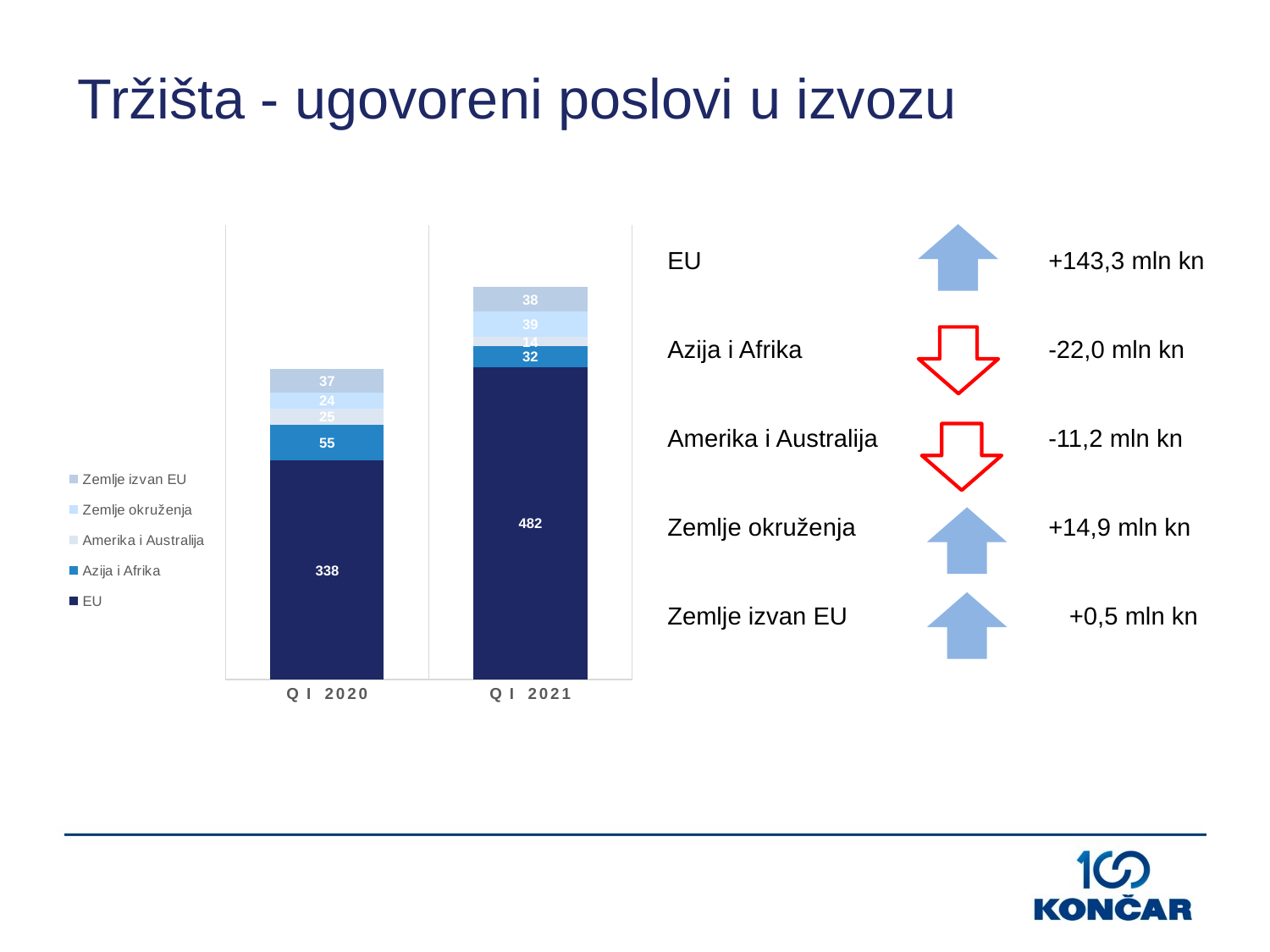
What is the value for EU in Q I 2021? 482 How many categories are shown on the x axis? 2 What is the total of the stacked bar for Q I 2021? 605 What kind of chart is shown on the slide? Stacked bar chart What is the value for Zemlje izvan EU in Q I 2020? 37 Which is larger, the Azija i Afrika value in Q I 2020 or in Q I 2021? Q I 2020 What is the difference between the EU values for Q I 2021 and Q I 2020? 144 What is the value for Amerika i Australija in Q I 2021? 14 What is the value for Zemlje okruženja in Q I 2021? 39 What is the value for Azija i Afrika in Q I 2020? 55 What is the total of the stacked bar for Q I 2020? 479 How many series does the legend list? 5